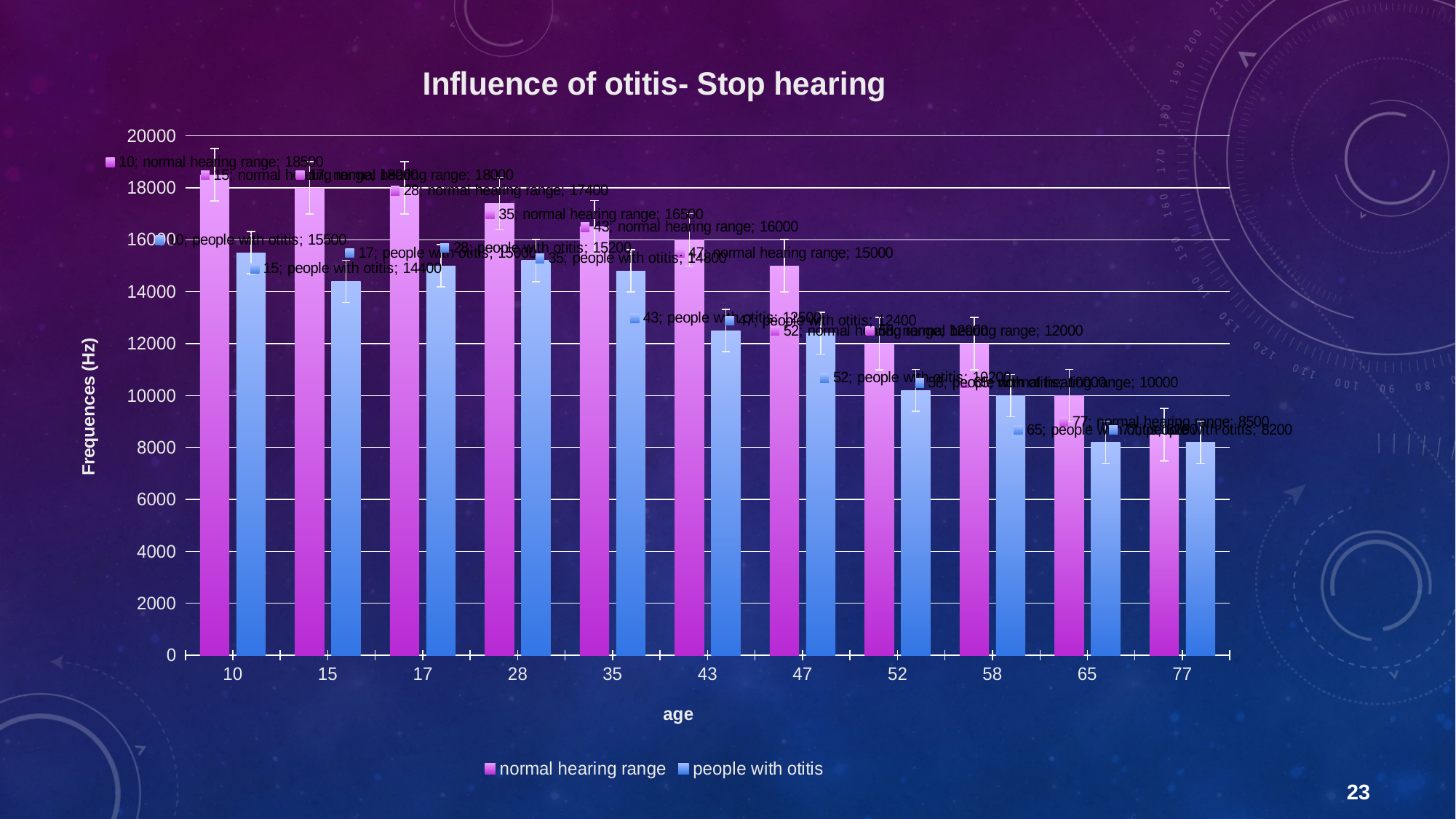
At age 35, which is larger: the normal hearing range or people with otitis? normal hearing range What is the value for people with otitis at age 10? 15500 What is the normal hearing range value at age 77? 8500 What is the difference between the normal hearing range and people with otitis at age 10? 3000 What is the normal hearing range value at age 10? 18500 What is the difference between the normal hearing range and people with otitis at age 28? 2200 What is the value for people with otitis at age 15? 14400 Do the normal hearing range values rise or fall as age increases? fall Is the value for people with otitis at age 47 greater or less than 14000? less How many age categories are shown on the x axis? 11 What is the normal hearing range value at age 28? 17400 At which age is the normal hearing range lowest? 77